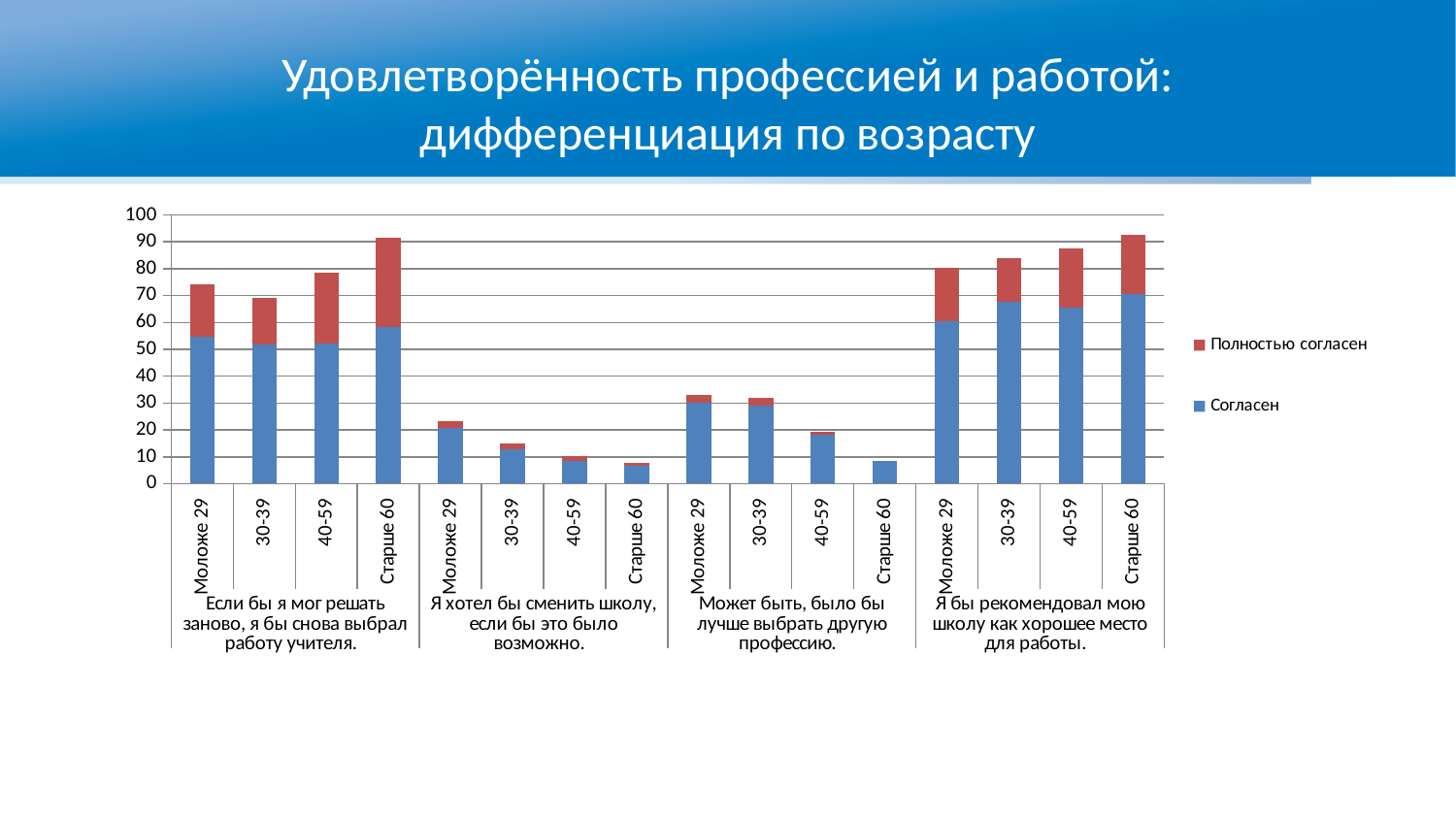
Is the total stacked value for 'Старше 60' under 'Если бы я мог решать заново, я бы снова выбрал работу учителя' greater or less than 80? greater For the statement 'Я бы рекомендовал мою школу как хорошее место для работы', which age group has the tallest stacked bar? Старше 60 What are the two series named in the legend? Полностью согласен and Согласен What kind of chart is shown on the slide? Stacked bar chart How many series does the legend list? 2 For the statement 'Если бы я мог решать заново, я бы снова выбрал работу учителя', which age group has the tallest stacked bar? Старше 60 How many statements (category groups) are shown along the x axis? 4 Is the total stacked value for 'Моложе 29' under 'Я хотел бы сменить школу, если бы это было возможно' greater or less than 30? less Which colour represents the series 'Согласен'? Blue How many bars are plotted in total on the chart? 16 For the statement 'Я хотел бы сменить школу, если бы это было возможно', do the stacked bars rise or fall as the age groups go from 'Моложе 29' to 'Старше 60'? Fall Under 'Может быть, было бы лучше выбрать другую профессию', which stacked bar is taller: 'Моложе 29' or '40-59'? Моложе 29